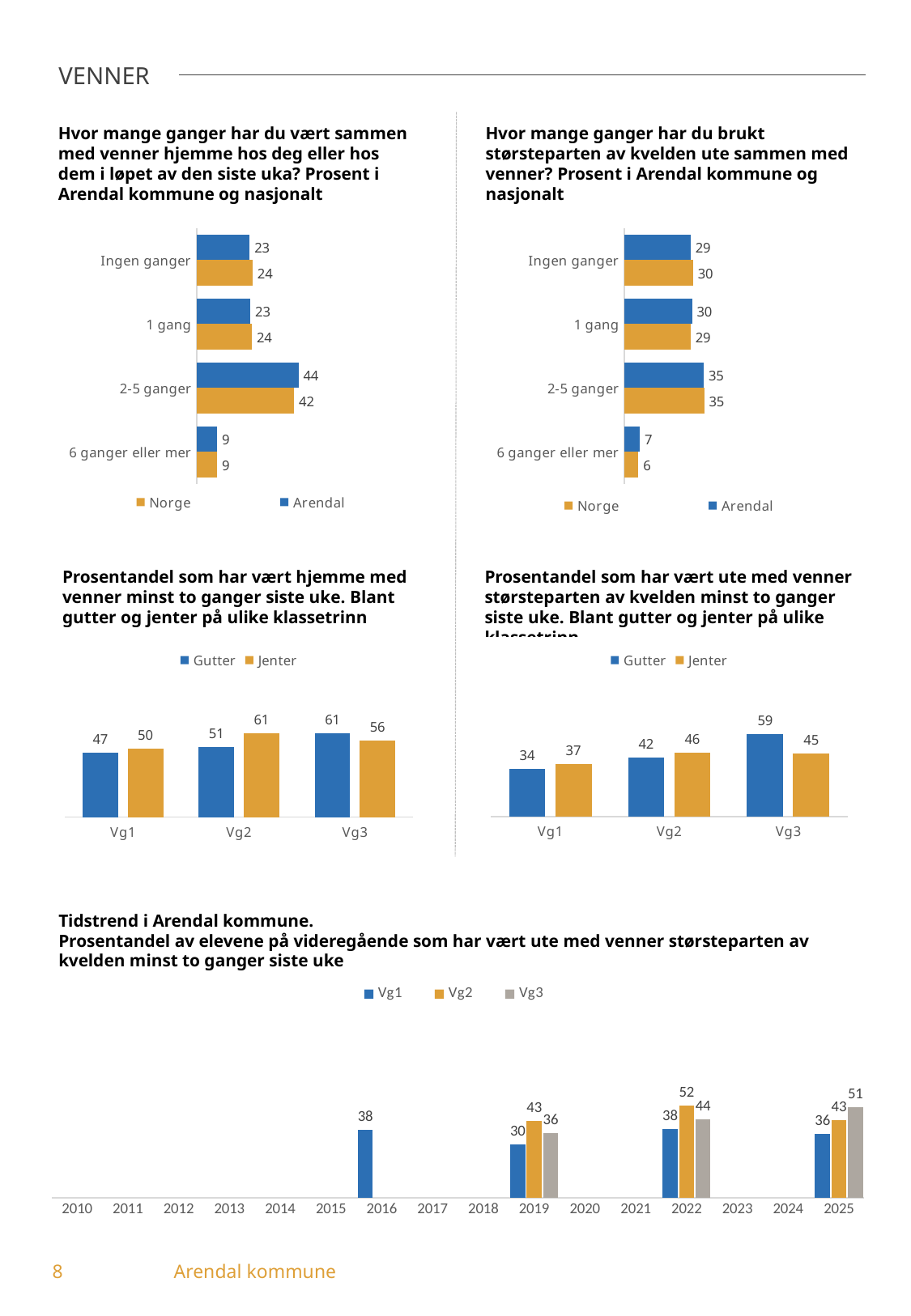
In the top-left chart about being with friends at home, what is the value for Norge in the 'Ingen ganger' category? 24 In the top-right chart about spending the evening out with friends, which category has the lowest value for Arendal? 6 ganger eller mer In the middle-right chart (ute med venner minst to ganger), what is the difference between Gutter and Jenter in Vg3? 14 In the top-right chart about spending the evening out with friends, how many categories are shown on the axis? 4 In the bottom chart (Tidstrend i Arendal kommune), how many series does the legend list? 3 In the top-left chart about being with friends at home, what is the value for Arendal in the '2-5 ganger' category? 44 In the middle-right chart (ute med venner minst to ganger), does the value for Gutter rise or fall from Vg1 to Vg3? rise In the top-right chart about spending the evening out with friends, what is the difference between Arendal and Norge for '6 ganger eller mer'? 1 In the middle-left chart (hjemme med venner minst to ganger), which is larger in Vg3: Gutter or Jenter? Gutter In the middle-left chart (hjemme med venner minst to ganger), what is the value for Jenter in Vg2? 61 What type of chart is the bottom chart (Tidstrend i Arendal kommune)? bar chart In the bottom chart (Tidstrend i Arendal kommune), what is the value for Vg2 in 2022? 52